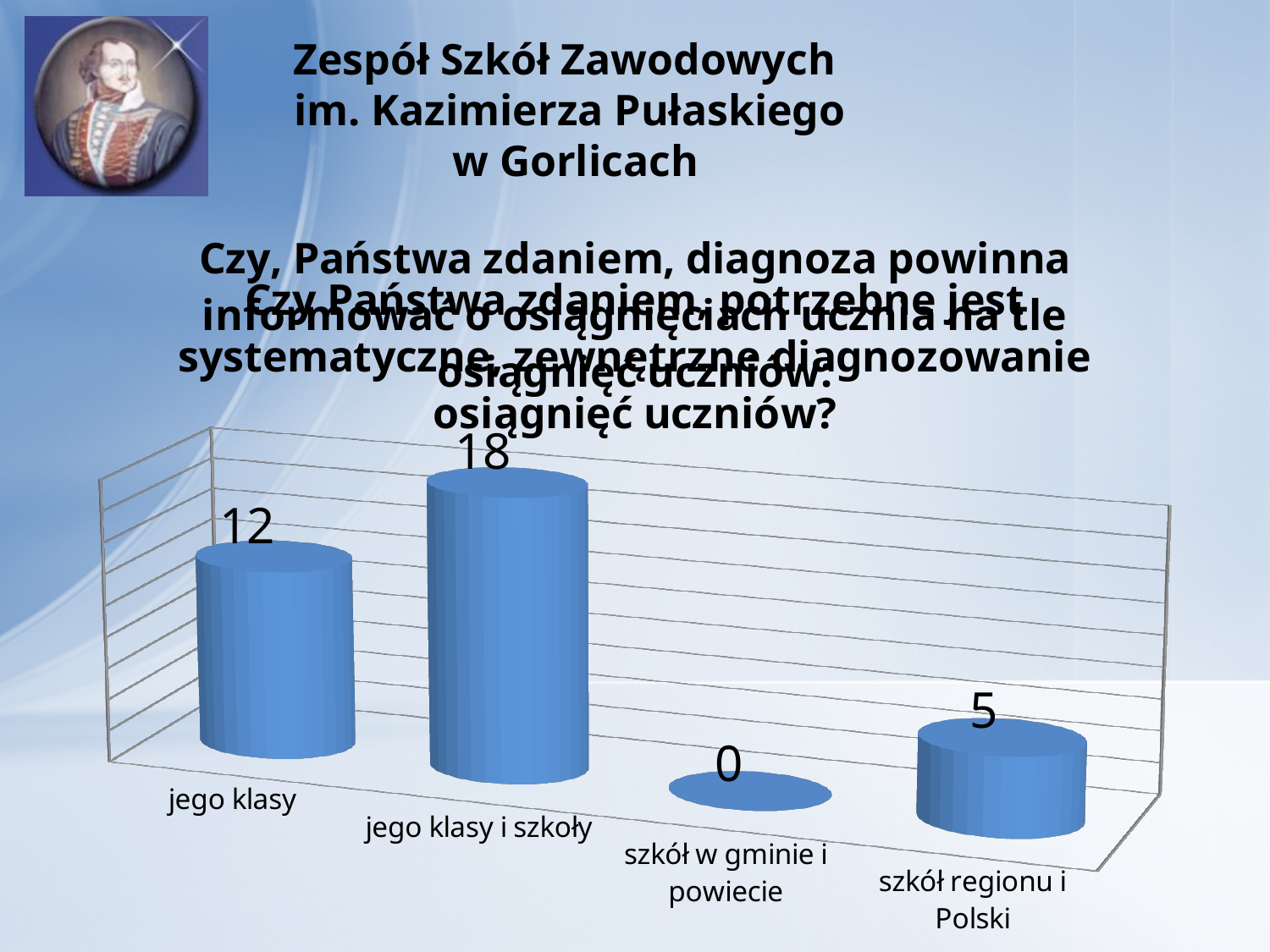
What colour are the bars in the chart? blue What value is shown for "szkół w gminie i powiecie"? 0 What value is shown for "jego klasy"? 12 Which category has the lowest value? szkół w gminie i powiecie What value is shown for "szkół regionu i Polski"? 5 What kind of chart is shown on the slide? bar chart What value is shown for "jego klasy i szkoły"? 18 What is the difference between the values for "jego klasy" and "szkół regionu i Polski"? 7 Which category has the highest value? jego klasy i szkoły Which is larger, the value for "jego klasy" or the value for "szkół regionu i Polski"? jego klasy How many categories are shown in the chart? 4 What is the difference between the values for "jego klasy i szkoły" and "jego klasy"? 6